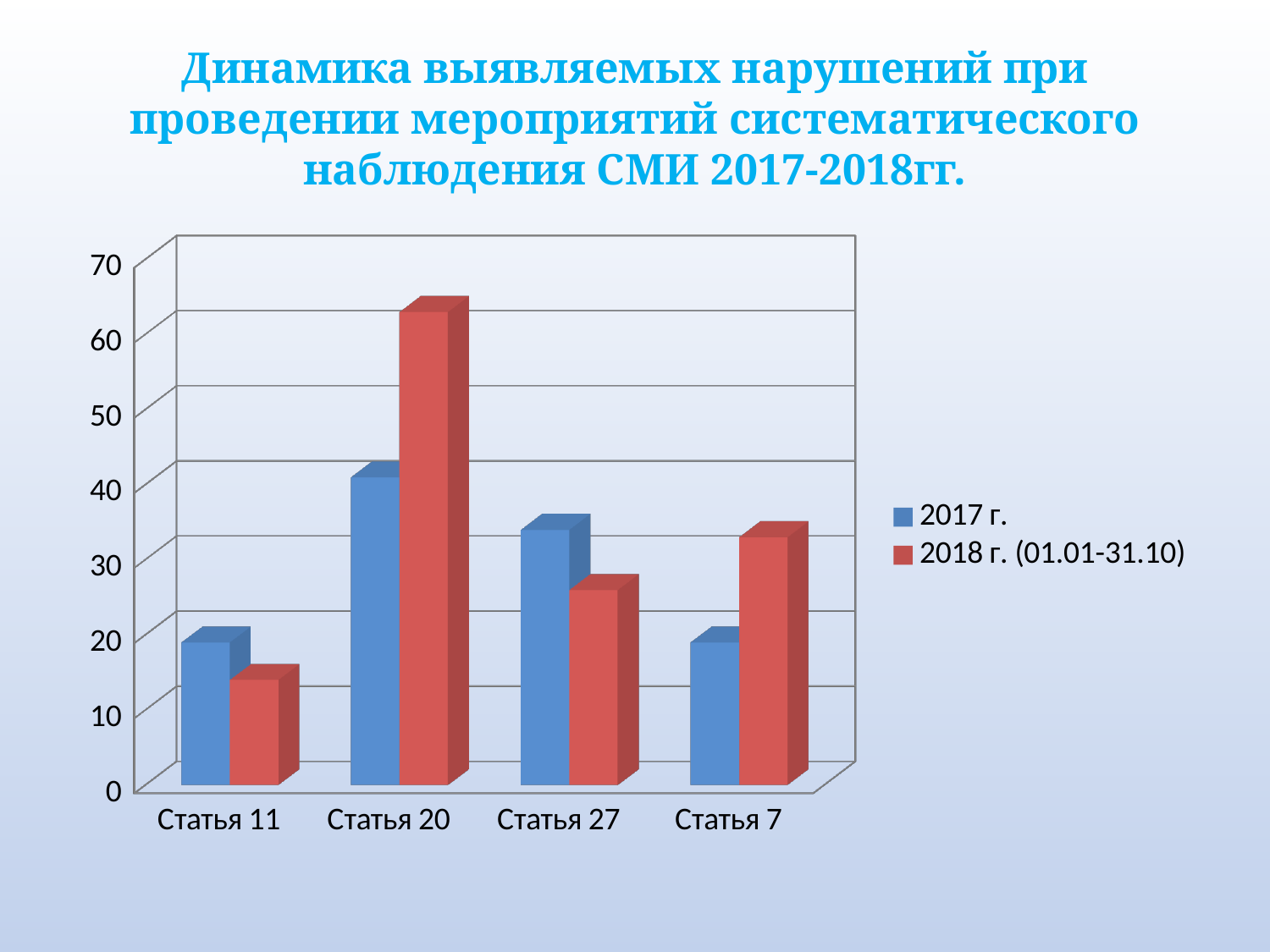
How many series does the legend list? 2 For Статья 20, which series has the larger value, 2017 г. or 2018 г. (01.01-31.10)? 2018 г. (01.01-31.10) Which colour represents the 2017 г. series in the legend? Blue How many categories (articles) are shown on the x axis? 4 Which category has the highest value for the 2017 г. series? Статья 20 Is the 2018 г. (01.01-31.10) value for Статья 20 greater or less than 50? greater Which category has the highest value for the 2018 г. (01.01-31.10) series? Статья 20 What kind of chart is shown on the slide? Bar chart Which category has the lowest value for the 2018 г. (01.01-31.10) series? Статья 11 For Статья 27, which series has the larger value, 2017 г. or 2018 г. (01.01-31.10)? 2017 г. Is the 2017 г. value for Статья 20 greater or less than 30? greater For Статья 7, which series has the larger value, 2017 г. or 2018 г. (01.01-31.10)? 2018 г. (01.01-31.10)